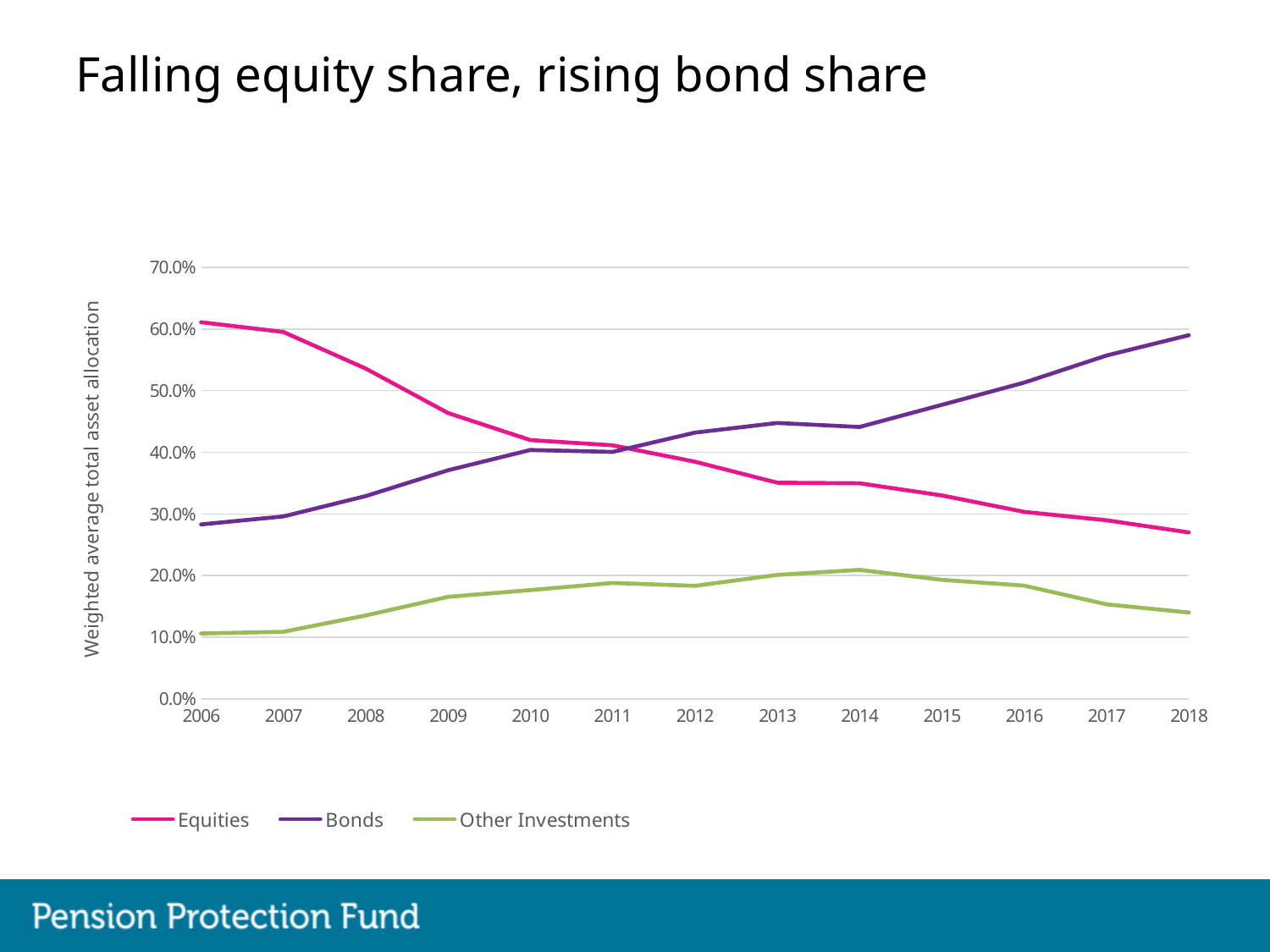
Does the Equities line rise or fall from 2006 to 2018? fall Is the value for Bonds in 2018 greater or less than 50.0%? greater Is the value for Other Investments in 2006 greater or less than 20.0%? less In 2006, which is larger: Equities or Bonds? Equities Does the Bonds line rise or fall from 2006 to 2018? rise What kind of chart is shown on the slide? line chart How many series does the legend list? 3 In which year is the Bonds value highest? 2018 How many years are plotted along the x axis? 13 Which series has the lowest value in 2018? Other Investments In which year is the Equities value lowest? 2018 Is the value for Equities in 2006 greater or less than 50.0%? greater